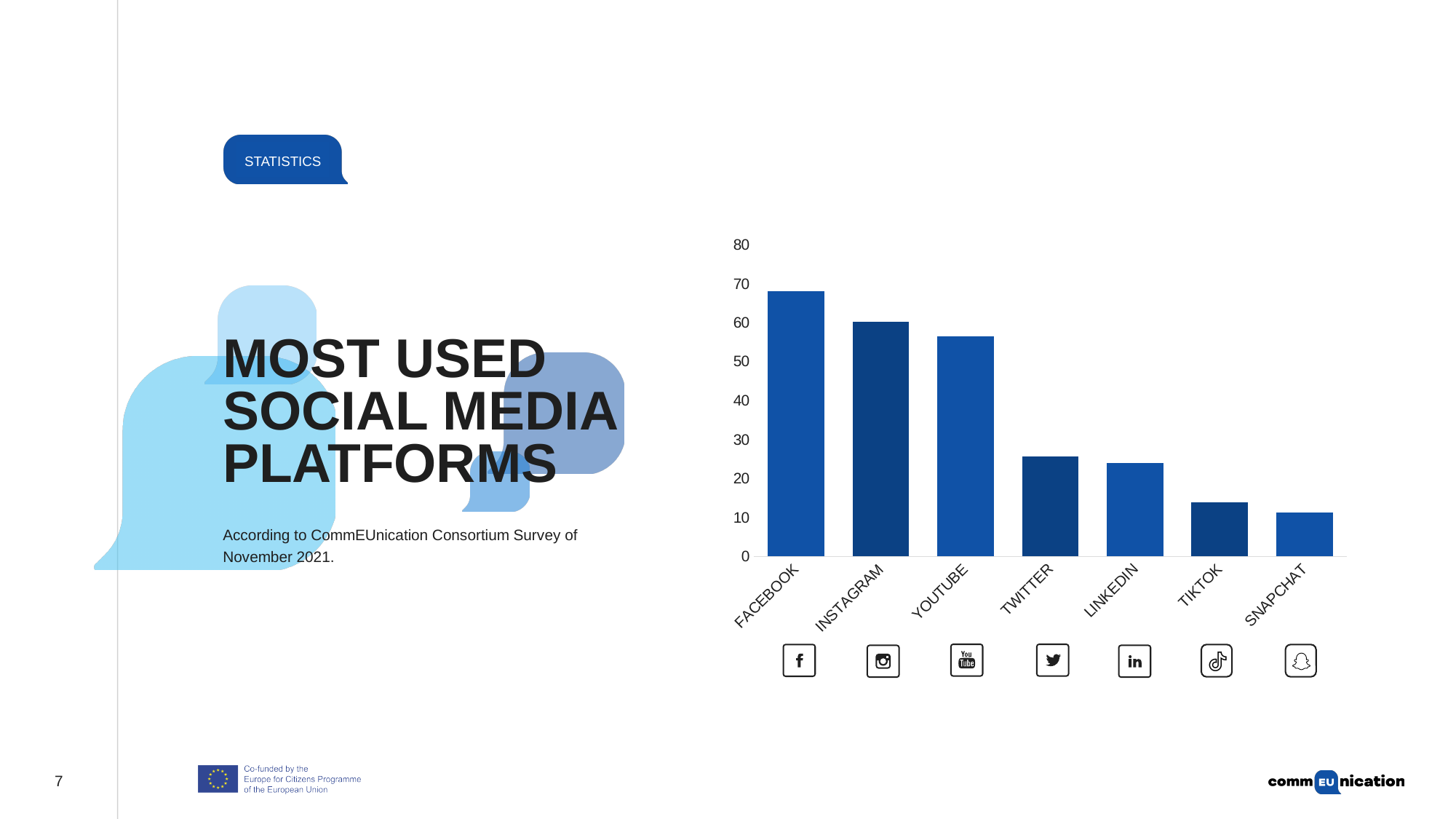
What kind of chart is shown on the slide? bar chart Do the values rise or fall moving from left to right along the x axis? fall Is the value for LINKEDIN greater or less than 20? greater Which platform has the highest value on the chart? FACEBOOK How many social media platforms are shown on the chart? 7 Is the value for TIKTOK greater or less than 20? less Which has a larger value, INSTAGRAM or YOUTUBE? INSTAGRAM Is the value for TWITTER greater or less than 30? less What is the title of the chart on the slide? MOST USED SOCIAL MEDIA PLATFORMS Which platform has the lowest value on the chart? SNAPCHAT